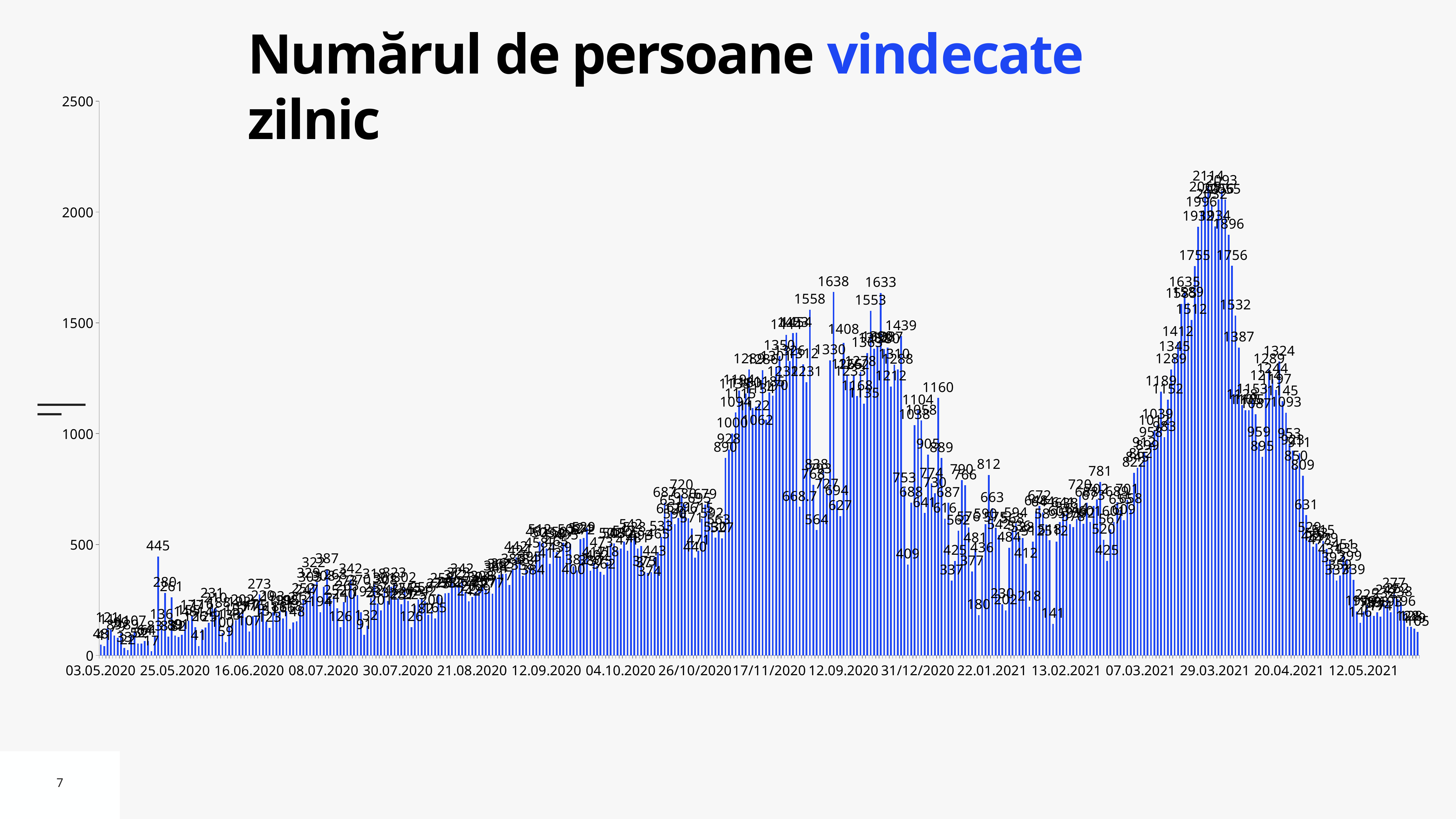
What is the highest data label shown on the chart? 2114 What is the highest tick value shown on the y axis? 2500 Are the bars around 29.03.2021 greater or less than 1500? greater What is the difference between the overall peak value 2114 and the autumn 2020 peak value 1638? 476 Are the bars around 03.05.2020 greater or less than 500? less What is the title of the chart? Numărul de persoane vindecate zilnic What is the value of the tall isolated bar near 25.05.2020? 445 Do the values rise or fall from 29.03.2021 to 12.05.2021? fall Which is larger, the peak value near 29.03.2021 (2114) or the peak value near 17/11/2020 (1638)? 2114 What kind of chart is shown on the slide? bar chart What is the highest data label shown in the autumn 2020 wave (between 26/10/2020 and 31/12/2020)? 1638 Do the values rise or fall from 13.02.2021 to 29.03.2021? rise